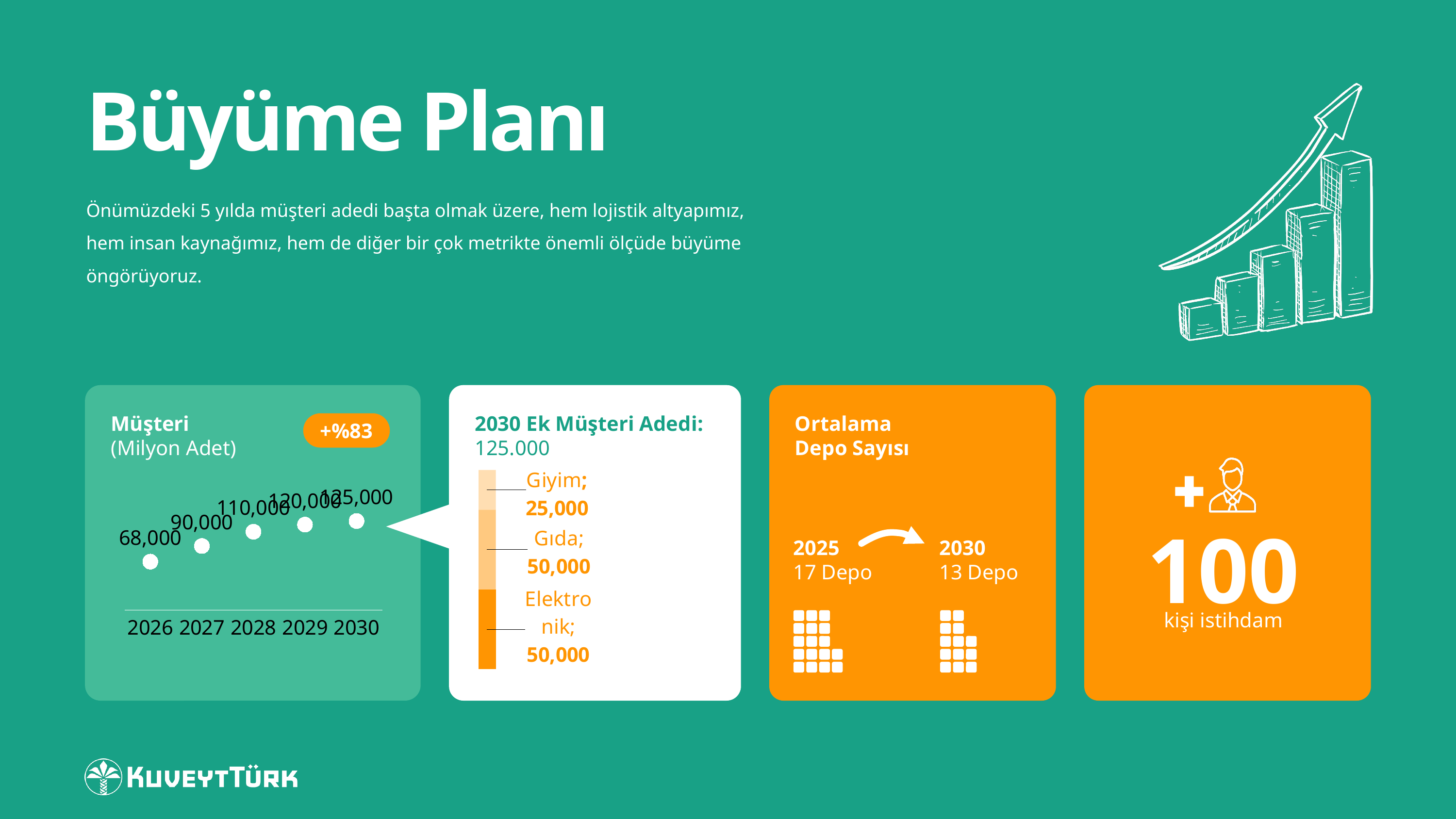
In the Müşteri (Milyon Adet) chart, what is the value for 2026? 68,000 In the Müşteri (Milyon Adet) chart, which year has the lowest value? 2026 In the Müşteri (Milyon Adet) chart, which year has the highest value? 2030 In the Müşteri (Milyon Adet) chart, what is the difference between the 2027 and 2026 values? 22,000 How many years are shown on the x axis of the Müşteri (Milyon Adet) chart? 5 In the 2030 Ek Müşteri Adedi stacked bar, which is larger, Giyim or Gıda? Gıda In the Müşteri (Milyon Adet) chart, what is the value for 2027? 90,000 What is the total of the 2030 Ek Müşteri Adedi stacked bar? 125,000 In the Müşteri (Milyon Adet) chart, what is the value for 2030? 125,000 In the Müşteri (Milyon Adet) chart, what is the value for 2028? 110,000 In the 2030 Ek Müşteri Adedi stacked bar, what is the value for Giyim? 25,000 In the Müşteri (Milyon Adet) chart, do the values rise or fall from 2026 to 2030? rise